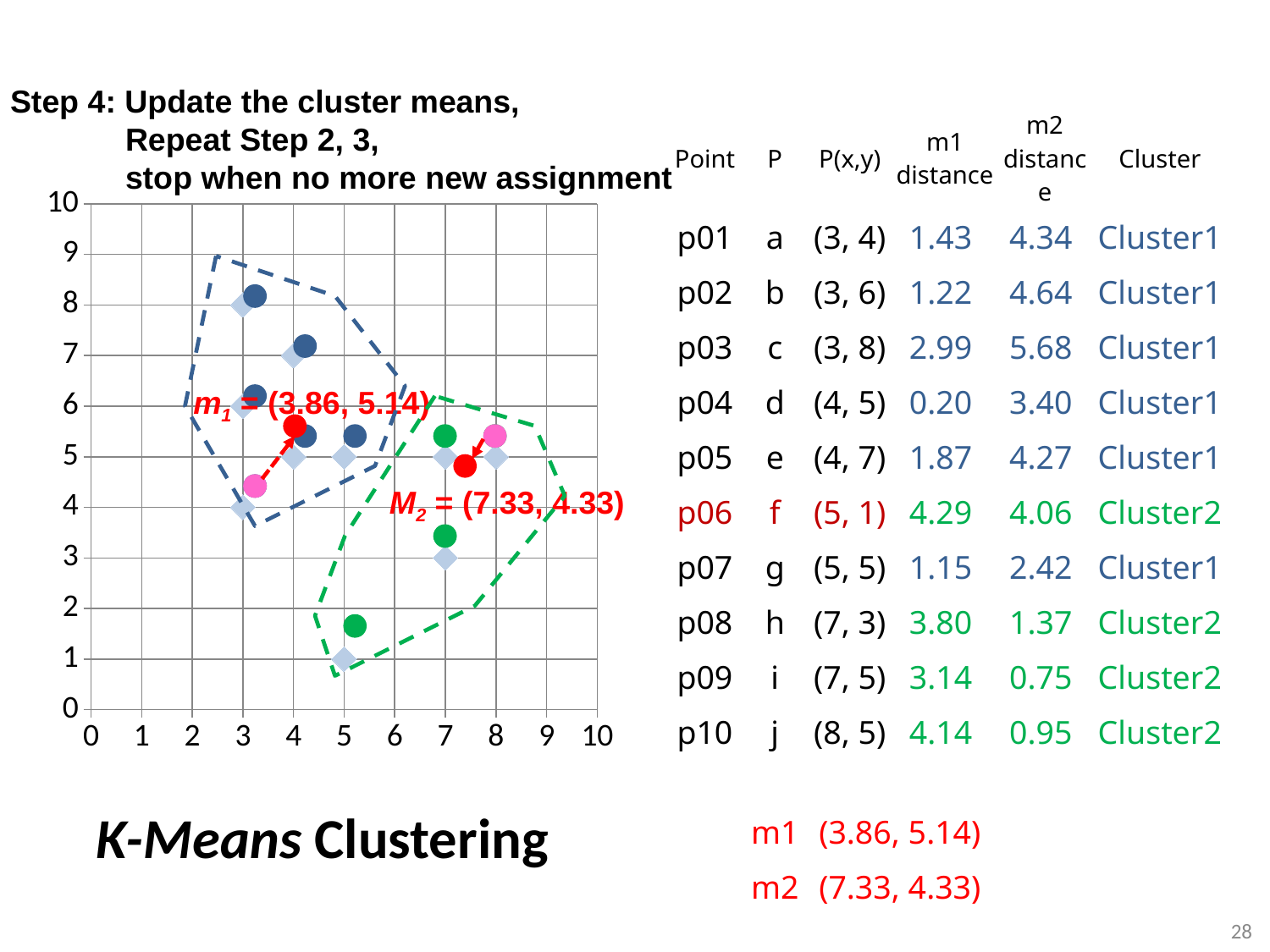
How many dashed cluster outlines are drawn on the chart? 2 Which cluster mean has the larger y coordinate, m1 or M2? m1 Which point has the highest y value on the chart? c (3, 8) Which point has the lowest y value on the chart? f (5, 1) What are the coordinates of the cluster mean M2 labelled on the chart? (7.33, 4.33) Is the x coordinate of cluster mean M2 greater or less than 7? greater Is the x coordinate of cluster mean m1 greater or less than 4? less What is the maximum value shown on the chart's x axis? 10 How many data points (light blue diamonds) are plotted on the chart? 10 What is the maximum value shown on the chart's y axis? 10 What are the coordinates of the cluster mean m1 labelled on the chart? (3.86, 5.14) What kind of chart is shown on the left of the slide? scatter chart